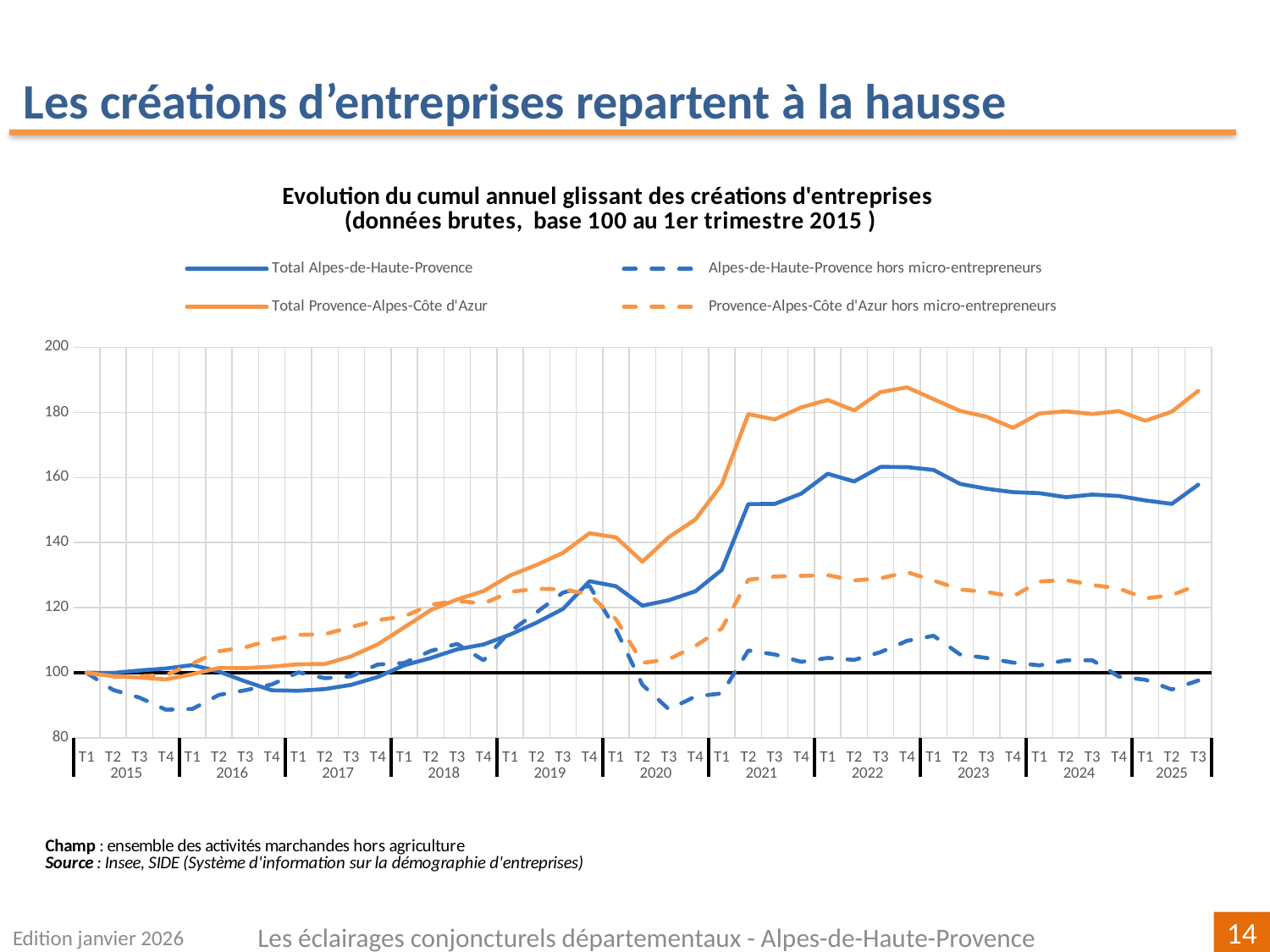
At T3 2025, which is larger: Total Provence-Alpes-Côte d'Azur or Total Alpes-de-Haute-Provence? Total Provence-Alpes-Côte d'Azur Is the value for Alpes-de-Haute-Provence hors micro-entrepreneurs at T3 2020 greater or less than 100? less Is the value for Total Provence-Alpes-Côte d'Azur at T4 2022 greater or less than 180? greater Which series has the lowest value at T3 2020? Alpes-de-Haute-Provence hors micro-entrepreneurs Which series reaches the highest value on the chart? Total Provence-Alpes-Côte d'Azur Does the Total Provence-Alpes-Côte d'Azur series rise or fall between T1 2015 and T1 2021? rise How many series does the legend list? 4 What is the value of all series at T1 2015? 100 Is the value for Total Alpes-de-Haute-Provence at T3 2025 greater or less than 140? greater How many years are labelled on the x axis? 11 What kind of chart is shown on the slide? line chart